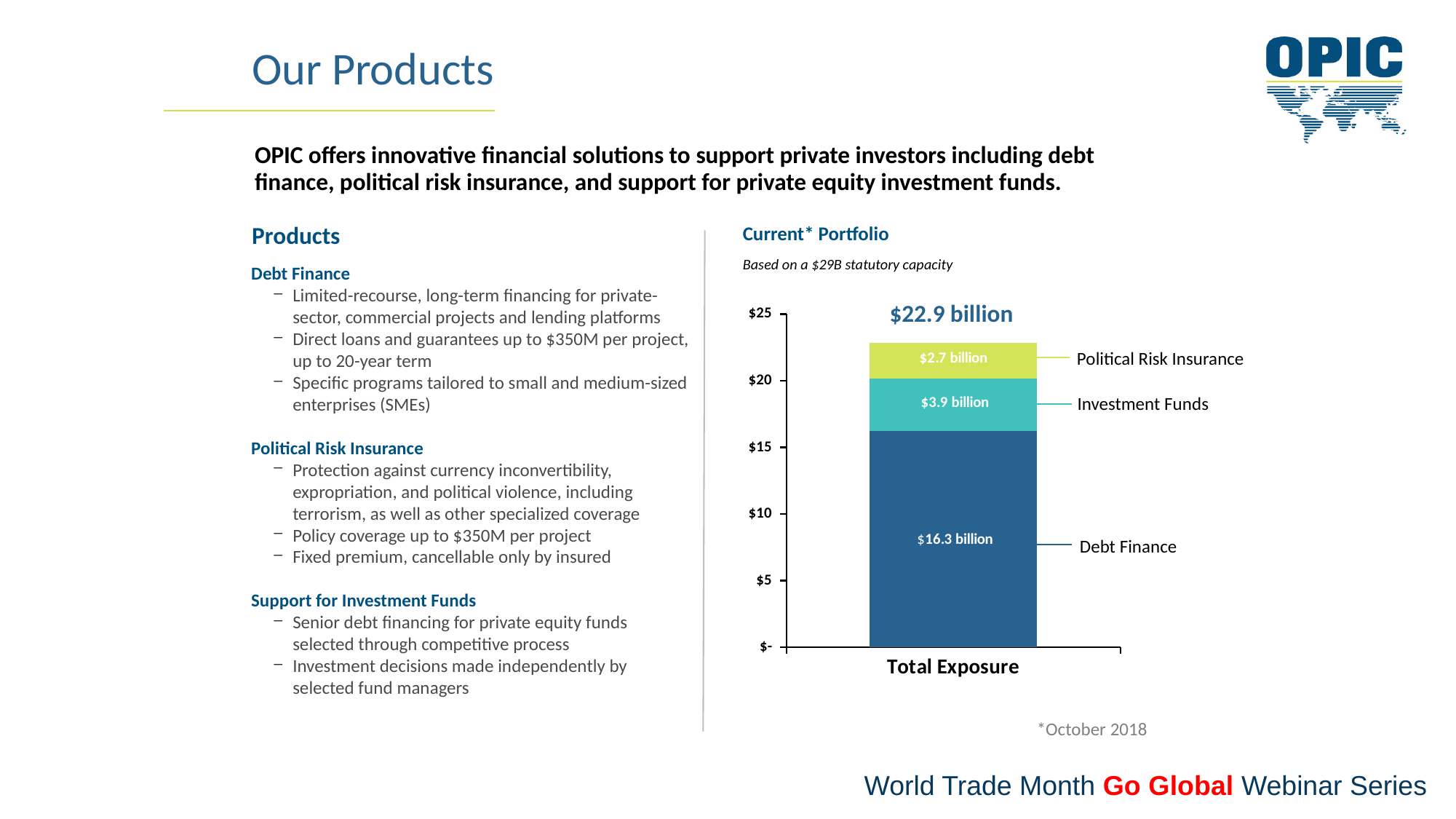
What is the difference between the Debt Finance and Investment Funds segments? $12.4 billion What is the difference between the Investment Funds and Political Risk Insurance segments? $1.2 billion Which segment of the Total Exposure bar is the largest? Debt Finance What is the value of the Debt Finance segment in the Total Exposure bar? $16.3 billion What is the value of the Political Risk Insurance segment in the Total Exposure bar? $2.7 billion What is the total of the stacked Total Exposure bar? $22.9 billion Which segment of the Total Exposure bar is the smallest? Political Risk Insurance What is the value of the Investment Funds segment in the Total Exposure bar? $3.9 billion What kind of chart is shown under Current* Portfolio? Stacked bar chart Is the total of the Total Exposure bar greater or less than $20? greater Which is larger, the Investment Funds segment or the Political Risk Insurance segment? Investment Funds What is the category label on the x axis of the chart? Total Exposure